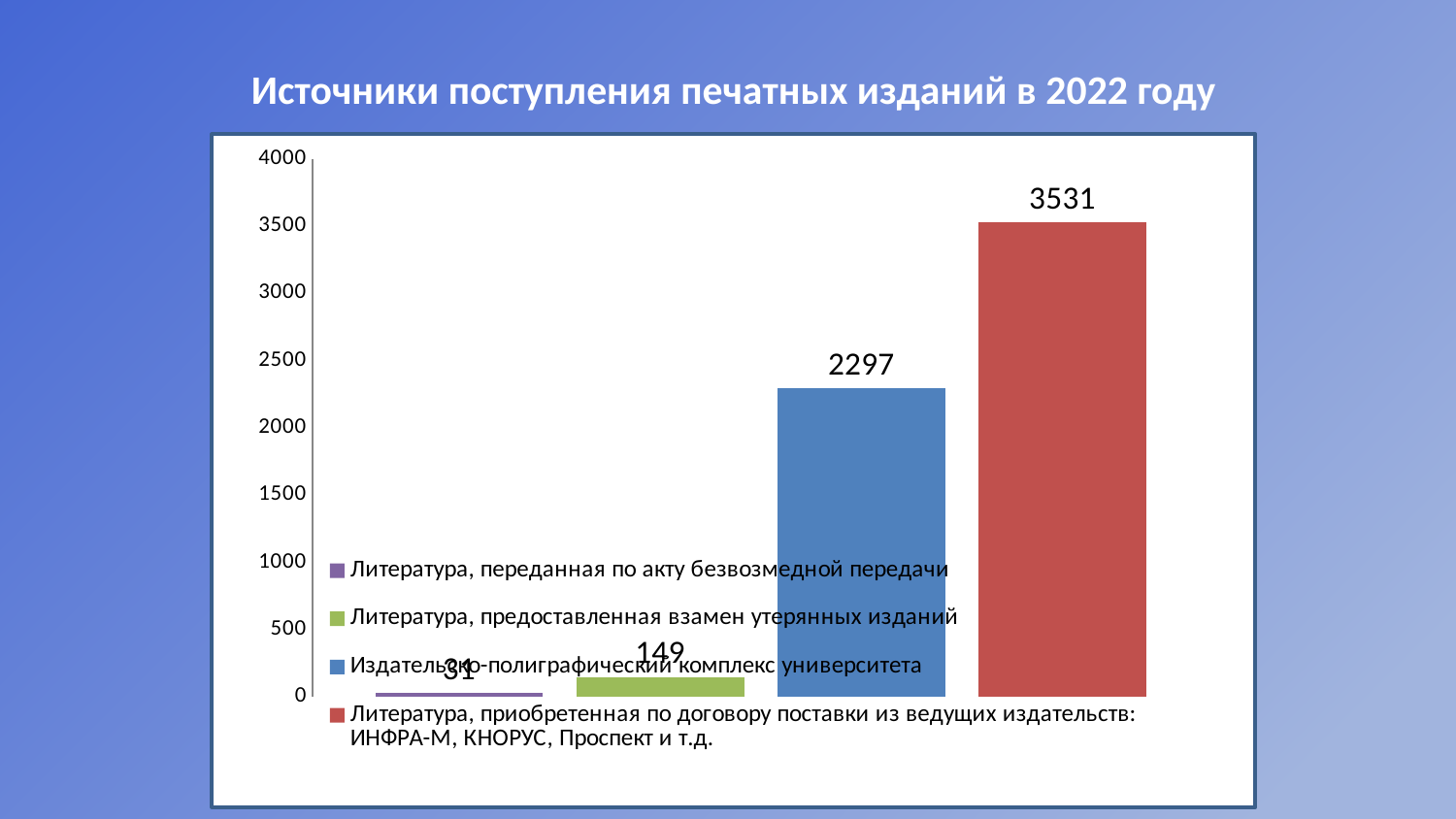
Which source has the highest value? Литература, приобретенная по договору поставки из ведущих издательств: ИНФРА-М, КНОРУС, Проспект и т.д. What kind of chart is shown on the slide? bar chart What is the value for Литература, приобретенная по договору поставки из ведущих издательств: ИНФРА-М, КНОРУС, Проспект и т.д.? 3531 Is the value for Литература, предоставленная взамен утерянных изданий greater or less than 500? less What is the value for Издательско-полиграфический комплекс университета? 2297 What is the title of the slide? Источники поступления печатных изданий в 2022 году What is the difference between the values for Литература, приобретенная по договору поставки and Издательско-полиграфический комплекс университета? 1234 Which source has the lowest value? Литература, переданная по акту безвозмедной передачи What is the value for Литература, предоставленная взамен утерянных изданий? 149 Is the value for Издательско-полиграфический комплекс университета greater or less than 2000? greater Which is larger: the value for Издательско-полиграфический комплекс университета or the value for Литература, предоставленная взамен утерянных изданий? Издательско-полиграфический комплекс университета How many series does the legend list? 4